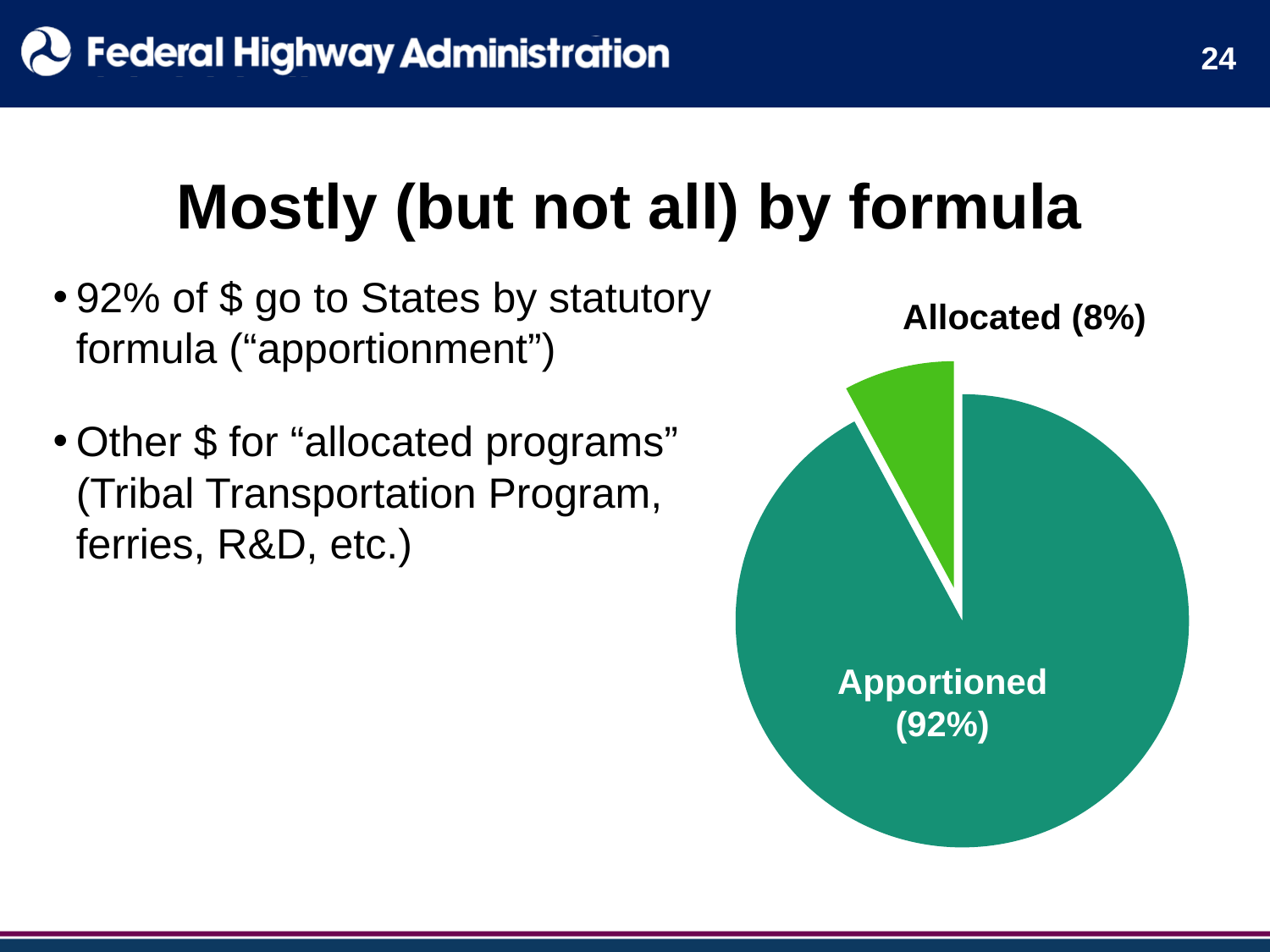
What is the difference in percentage points between the Apportioned and Allocated slices? 84 What colour is the Allocated slice of the pie? light green Which slice of the pie is the largest? Apportioned What share of the pie is Apportioned? 92% Which slice of the pie is the smallest? Allocated Which slice is pulled out (exploded) from the pie? Allocated Which is larger, the Apportioned slice or the Allocated slice? Apportioned What is the total of the two slices shown in the pie chart? 100% How many slices does the pie chart have? 2 What kind of chart is shown on the slide? pie chart What share of the pie is Allocated? 8%